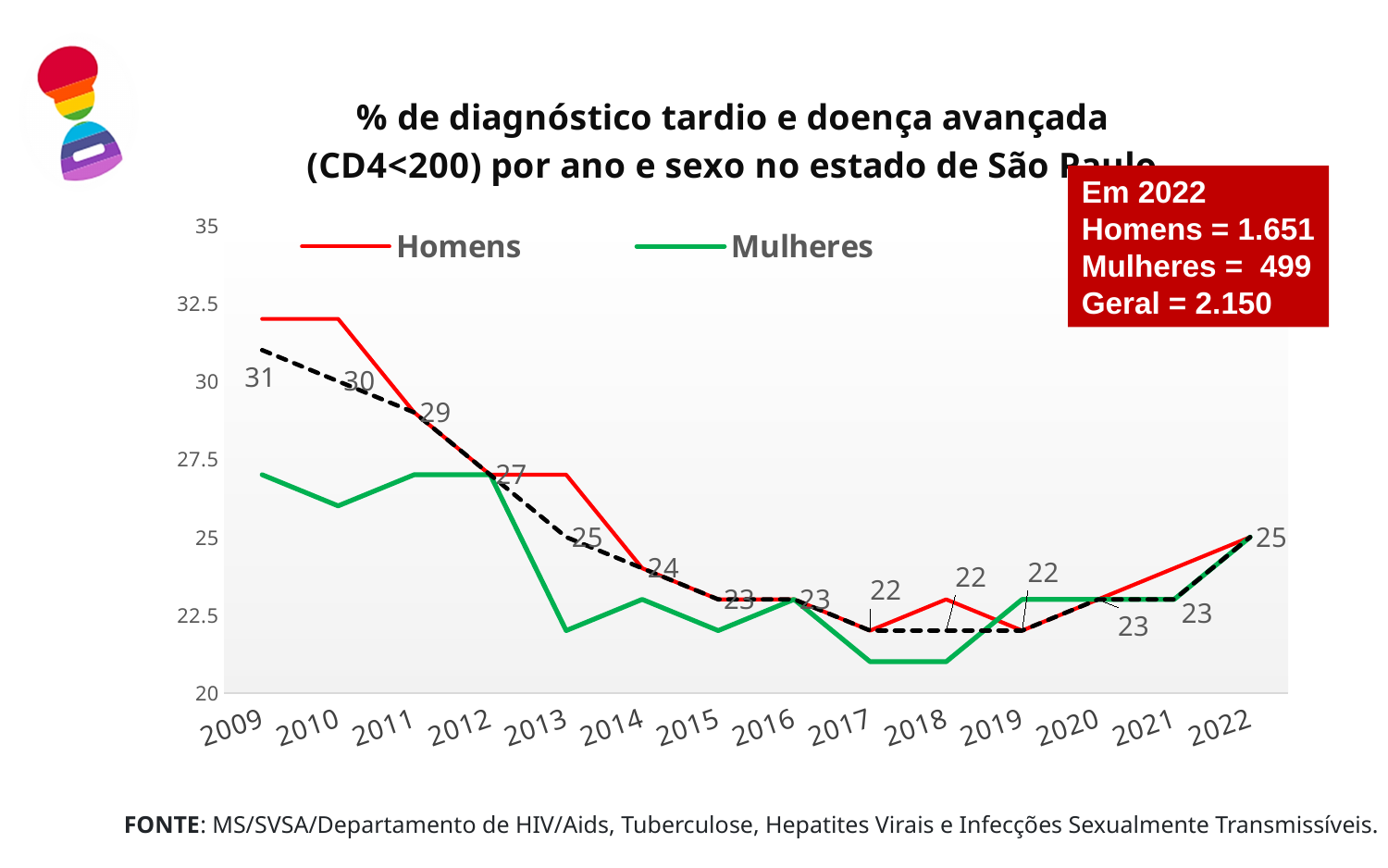
What is the difference between the dashed black line's labelled values for 2009 and 2022? 6 Is the value for Mulheres in 2017 greater or less than 22.5? less What kind of chart is shown on the slide? line chart Does the dashed black line generally rise or fall from 2009 to 2019? fall What value is labelled on the dashed black line for 2013? 25 How many years are shown on the x axis? 14 In which year does the dashed black line reach its highest labelled value? 2009 Is the value for Homens in 2009 greater or less than 30? greater How many series does the legend list? 2 What value is labelled on the dashed black line for 2009? 31 What value is labelled on the dashed black line for 2022? 25 In 2009, which series is higher, Homens or Mulheres? Homens